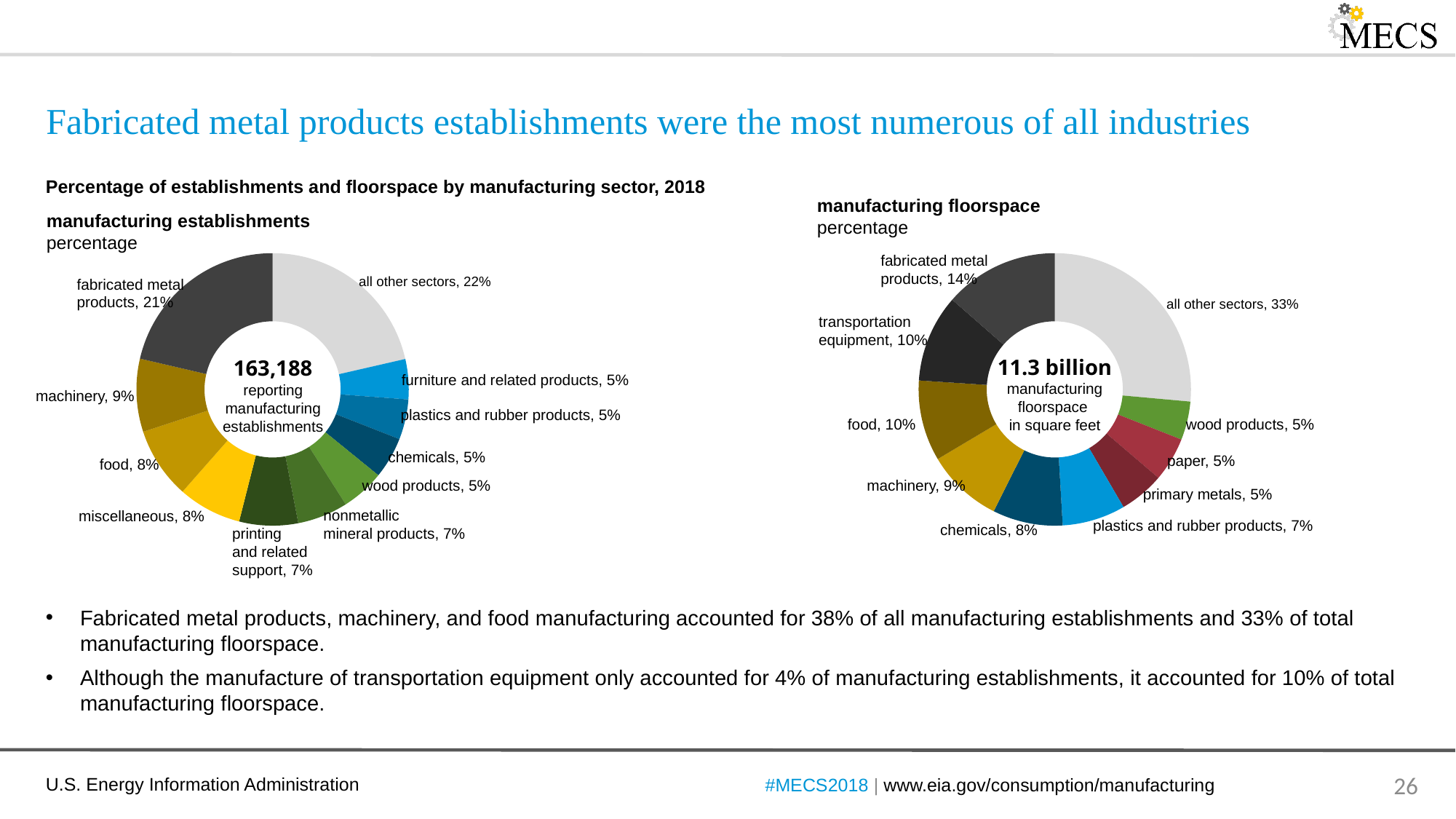
In the manufacturing establishments chart, what percentage is machinery? 9% In the manufacturing establishments chart, which slice is the largest? all other sectors How many slices does the manufacturing floorspace chart have? 10 What type of chart is used for manufacturing floorspace? donut (pie) chart In the manufacturing floorspace chart, which named sector (excluding all other sectors) has the largest share? fabricated metal products In the manufacturing floorspace chart, what percentage is transportation equipment? 10% Which is larger: the chemicals share in the manufacturing establishments chart or the chemicals share in the manufacturing floorspace chart? manufacturing floorspace In the manufacturing establishments chart, what is the difference between fabricated metal products and machinery? 12% In the manufacturing establishments chart, what percentage is fabricated metal products? 21% In the manufacturing floorspace chart, what is the difference between the food share and the wood products share? 5% What number is shown in the center of the manufacturing establishments chart? 163,188 How many slices does the manufacturing establishments chart have? 11